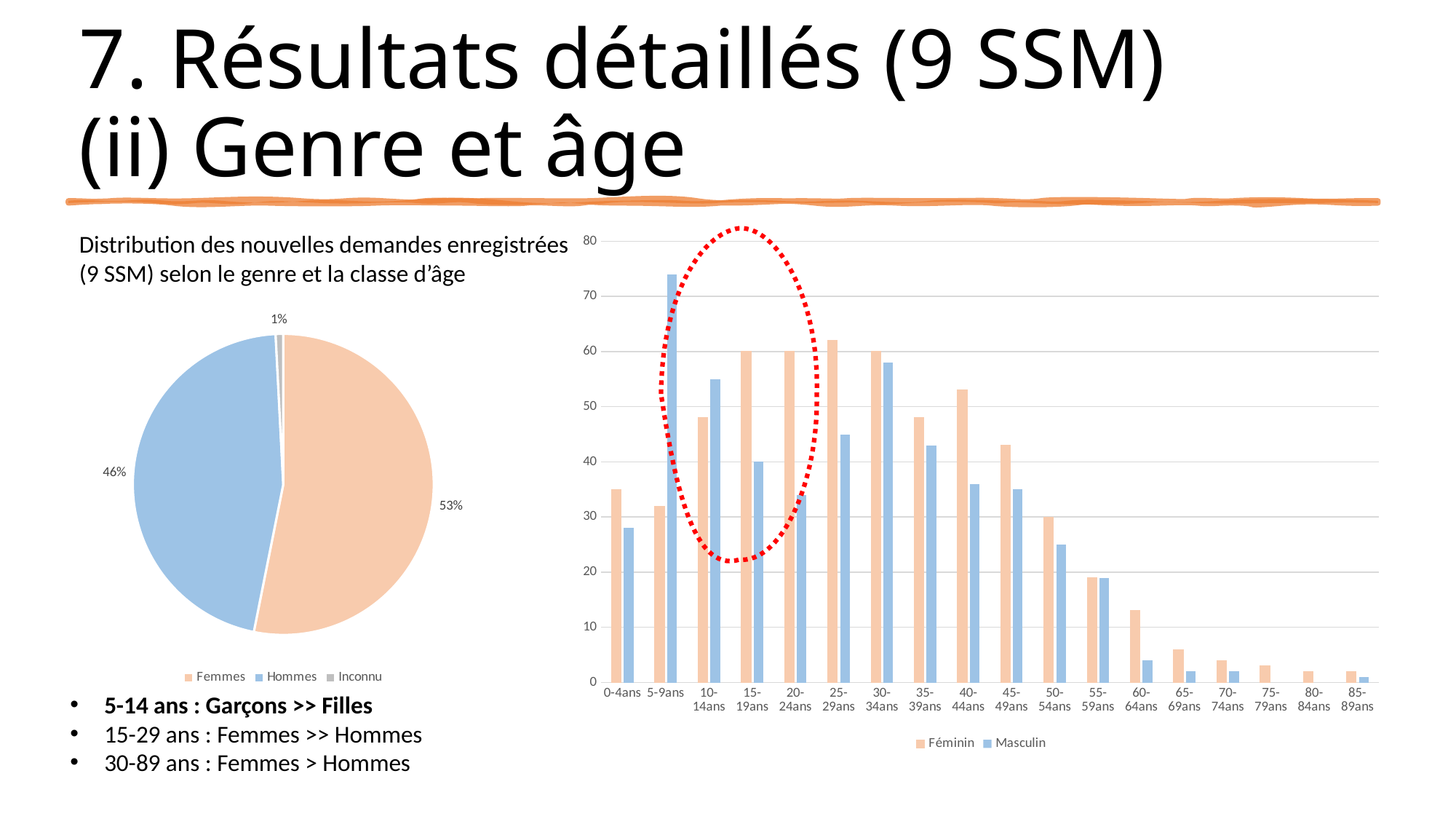
On the bar chart on the right, is the Masculin value for 5-9ans greater or less than 70? greater On the bar chart on the right, which age class has the highest Masculin value? 5-9ans On the bar chart on the right, is the Masculin value for 50-54ans greater or less than 30? less How many slices does the pie chart have? 3 On the bar chart on the right, which is larger for 15-19ans, Féminin or Masculin? Féminin On the pie chart, which category has the smallest slice? Inconnu On the bar chart on the right, how many age classes are shown on the x axis? 18 What kind of chart is the chart on the right side of the slide? Bar chart On the pie chart, what is the difference in percentage points between the Femmes and Hommes slices? 7 percentage points On the pie chart, what share is shown for Hommes? 46% How many series does the legend of the bar chart on the right list? 2 On the pie chart, what share is shown for Femmes? 53%